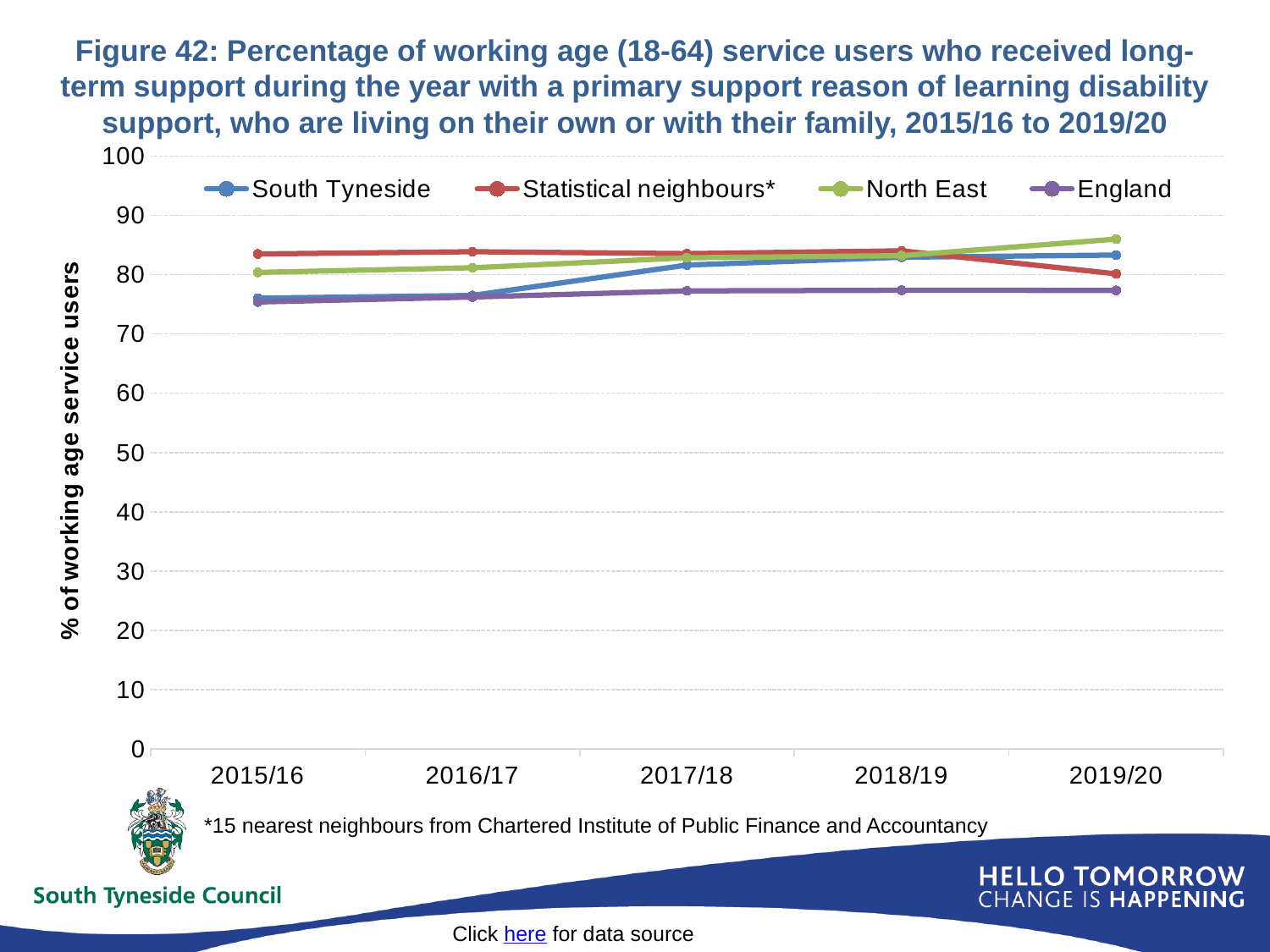
Does the South Tyneside line rise or fall from 2015/16 to 2019/20? rise Is the value for South Tyneside in 2015/16 greater or less than 80? less In 2015/16, which is larger: South Tyneside or Statistical neighbours*? Statistical neighbours* What kind of chart is shown on the slide? line chart Which series has the lowest value in 2019/20? England Which series has the highest value in 2019/20? North East Is the value for Statistical neighbours* in 2015/16 greater or less than 80? greater What is the label on the y axis? % of working age service users Is the value for North East in 2019/20 greater or less than 80? greater How many series does the legend list? 4 How many years are plotted along the x axis? 5